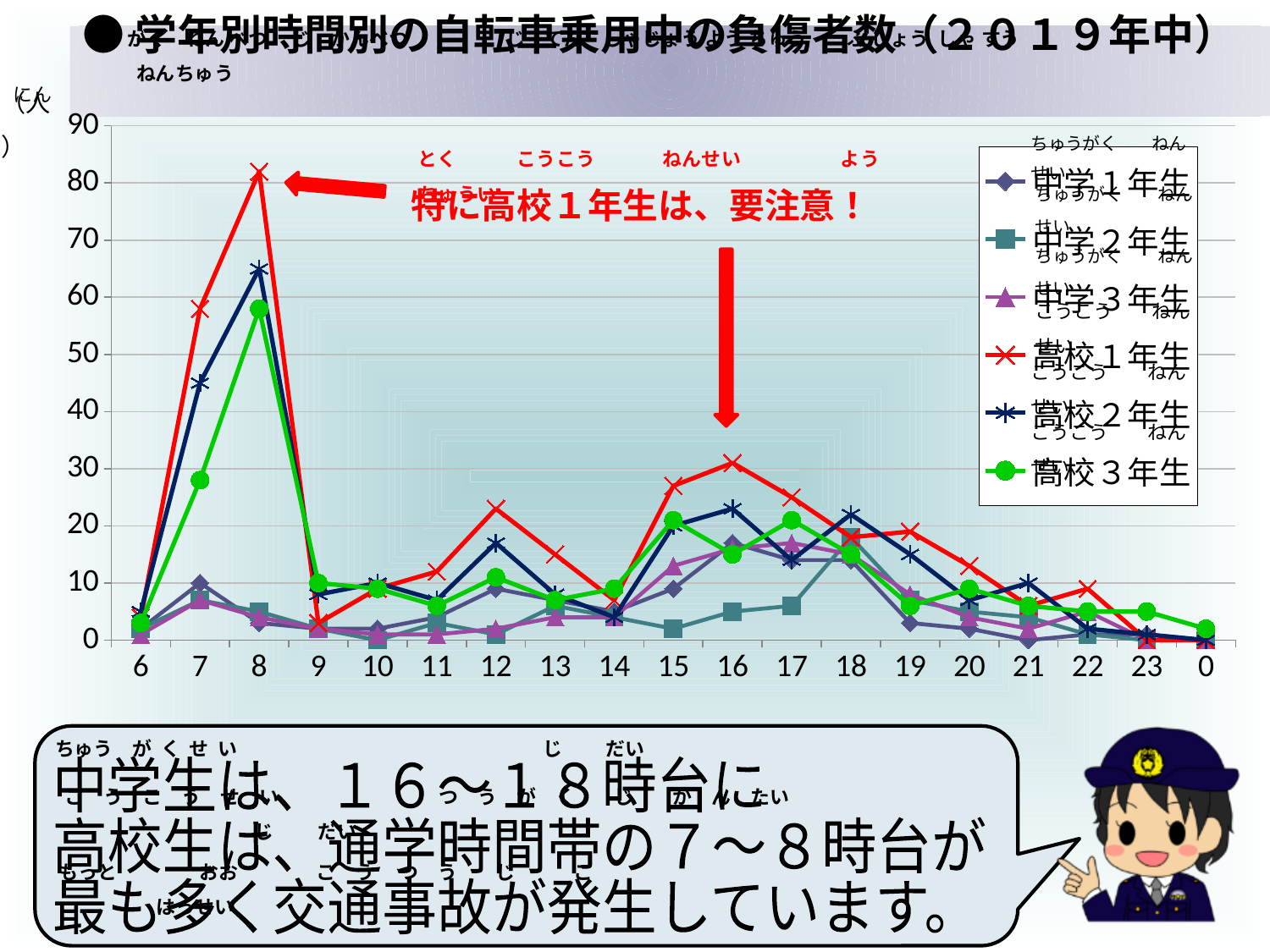
How many series does the legend list? 6 Is the value for 高校１年生 at hour 8 greater or less than 70? greater Which series reaches the highest value on the chart? 高校１年生 At hour 8, which is larger: 高校１年生 or 高校３年生? 高校１年生 Does the 高校１年生 series rise or fall from hour 6 to hour 8? rise What is the title of the chart? 学年別時間別の自転車乗用中の負傷者数（２０１９年中） Is the value for 高校２年生 at hour 8 greater or less than 60? greater Is the value for 高校３年生 at hour 7 greater or less than 20? greater At which hour does the 高校１年生 series reach its peak? 8 How many hour categories are shown on the x axis? 19 What kind of chart is shown on the slide? line chart At hour 7, which is larger: 高校１年生 or 高校２年生? 高校１年生